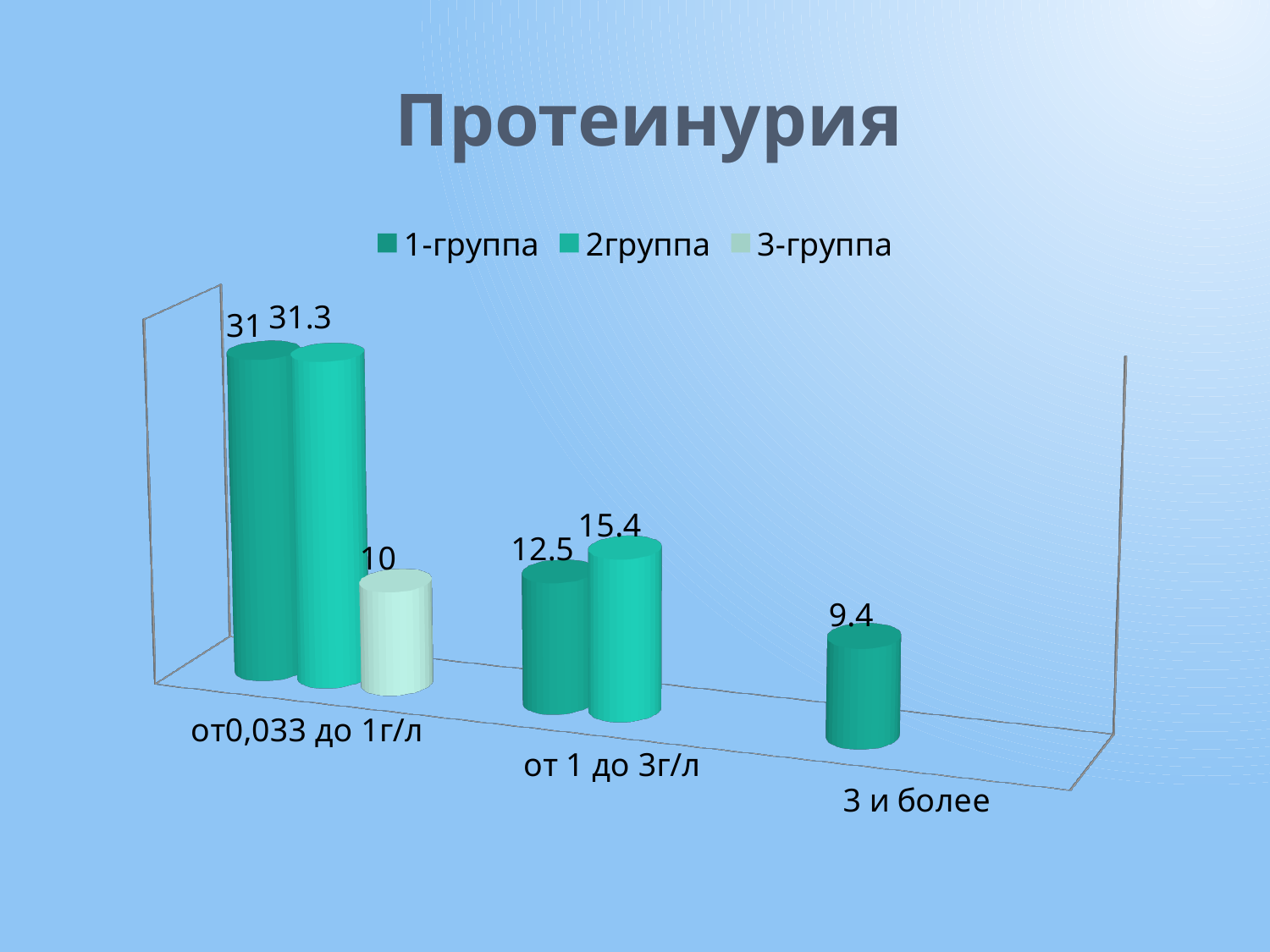
What is the value for 2группа in the category от 1 до 3г/л? 15.4 How many categories are shown on the x axis? 3 Which category has the highest value for 1-группа? от0,033 до 1г/л What is the title of the chart? Протеинурия What is the value for 1-группа in the category 3 и более? 9.4 In the category от 1 до 3г/л, which is larger: 1-группа or 2группа? 2группа What is the value for 3-группа in the category от0,033 до 1г/л? 10 What is the value for 2группа in the category от0,033 до 1г/л? 31.3 How many series does the legend list? 3 What is the value for 1-группа in the category от0,033 до 1г/л? 31 What is the difference between the 2группа and 1-группа values in the category от 1 до 3г/л? 2.9 Which category has the lowest value for 1-группа? 3 и более